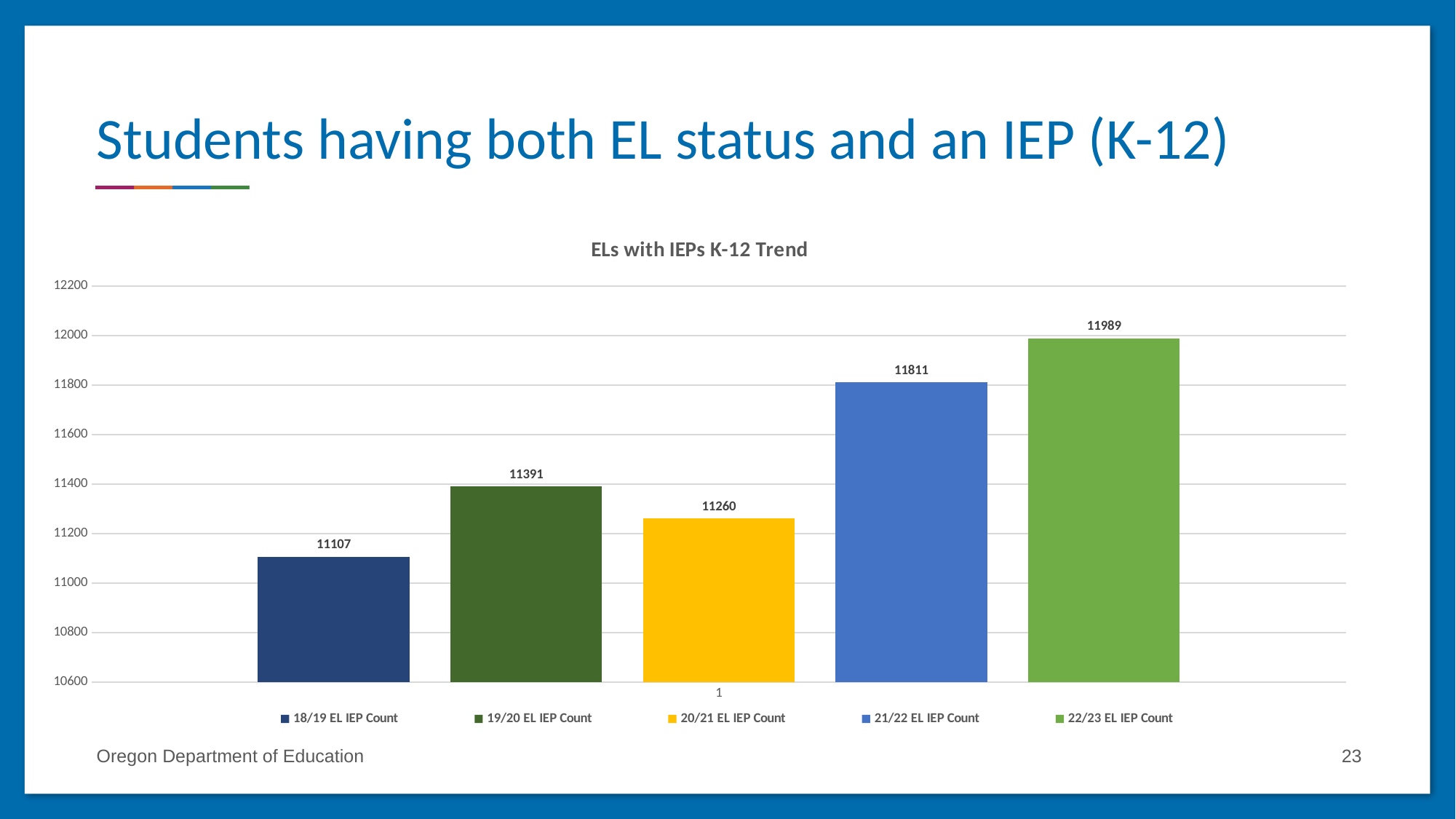
Which is larger, the 19/20 EL IEP Count or the 20/21 EL IEP Count? 19/20 EL IEP Count Is the 21/22 EL IEP Count greater or less than 11600? greater What is the difference between the 22/23 EL IEP Count and the 21/22 EL IEP Count? 178 Which school year has the lowest EL IEP Count? 18/19 What is the 22/23 EL IEP Count shown on the chart? 11989 What is the difference between the 19/20 EL IEP Count and the 20/21 EL IEP Count? 131 What is the title of the chart? ELs with IEPs K-12 Trend Which school year has the highest EL IEP Count? 22/23 What kind of chart is shown on the slide? Bar chart What is the 18/19 EL IEP Count shown on the chart? 11107 What is the 20/21 EL IEP Count shown on the chart? 11260 How many series does the legend list? 5